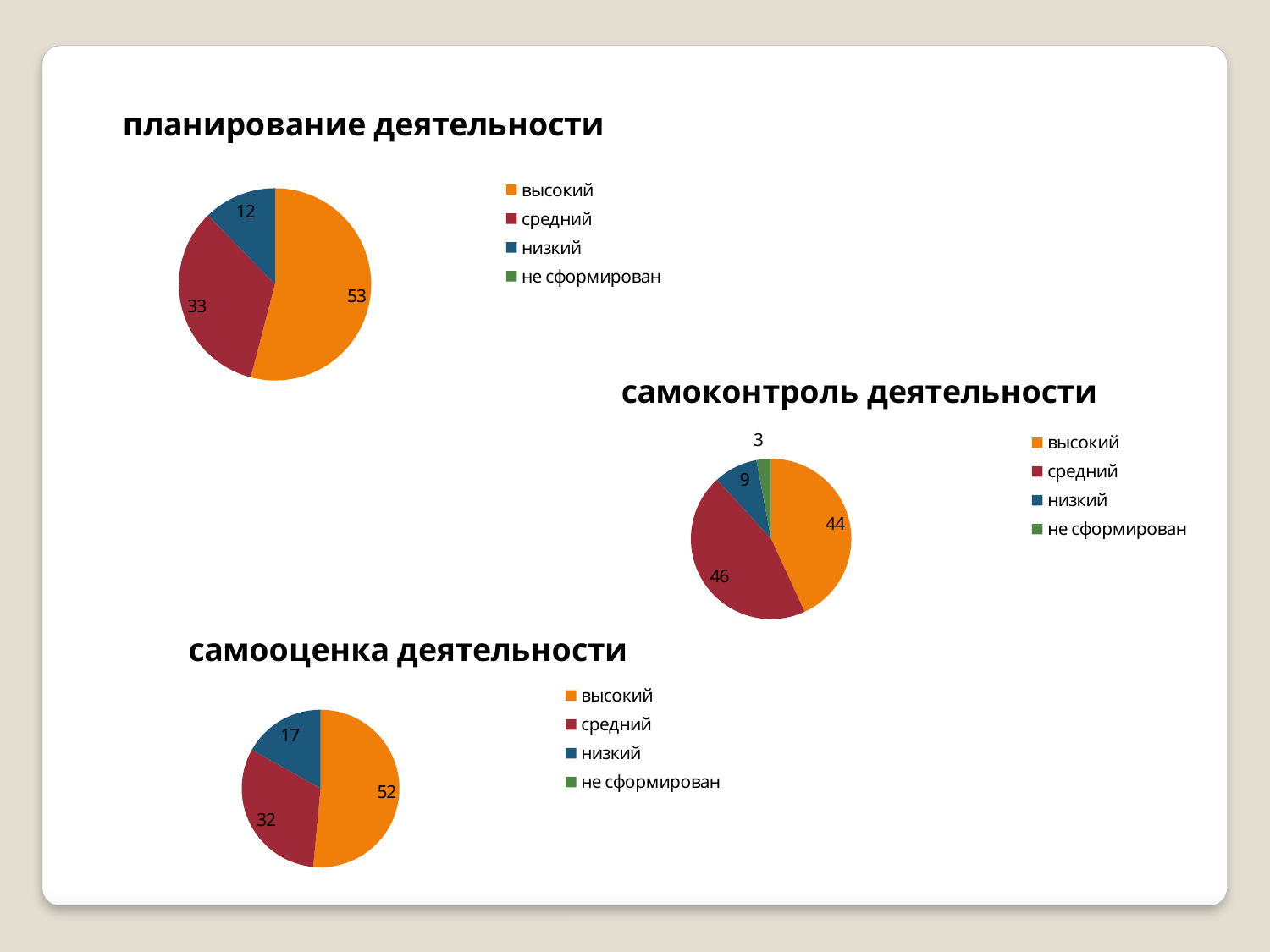
In the 'самооценка деятельности' pie chart, what is the value for 'низкий'? 17 In the 'планирование деятельности' pie chart, which category has the largest slice? высокий In the 'самоконтроль деятельности' pie chart, which category has the smallest slice? не сформирован In the 'самооценка деятельности' pie chart, what is the difference between the 'средний' and 'низкий' values? 15 In the 'планирование деятельности' pie chart, what is the value for 'высокий'? 53 How many entries does the legend of the 'самооценка деятельности' chart list? 4 In the 'самоконтроль деятельности' pie chart, which is larger, 'высокий' or 'средний'? средний In the 'планирование деятельности' pie chart, what is the value for 'низкий'? 12 In the 'самоконтроль деятельности' pie chart, what is the value for 'не сформирован'? 3 What type of chart is used for 'самоконтроль деятельности'? pie chart In the 'планирование деятельности' pie chart, what is the difference between the 'высокий' and 'средний' values? 20 In the 'самоконтроль деятельности' pie chart, what is the value for 'средний'? 46